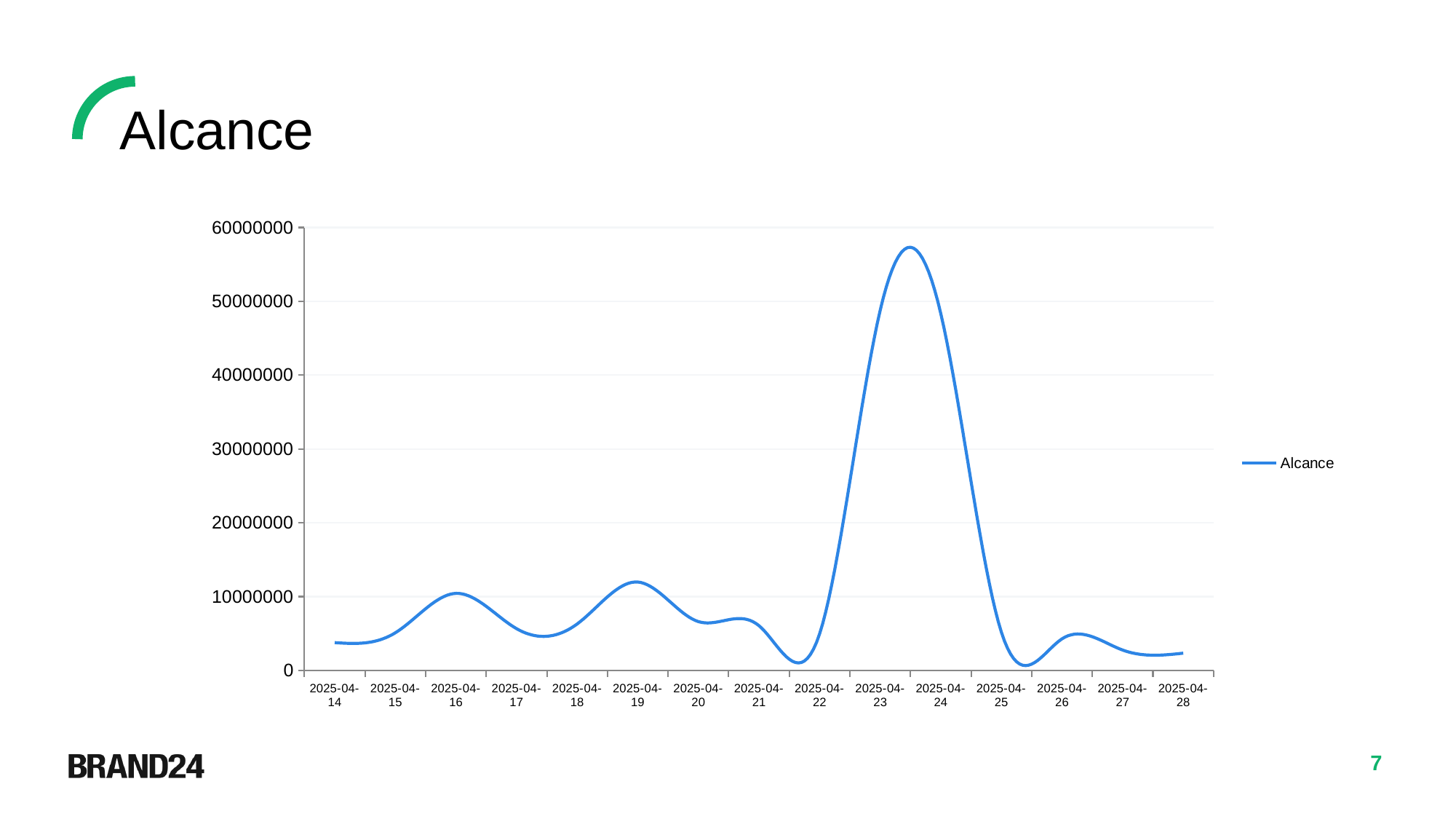
What kind of chart is shown on the slide? line chart Is the value for 2025-04-22 greater or less than 10000000? less Does the line rise or fall from 2025-04-24 to 2025-04-25? fall Is the value for 2025-04-23 greater or less than 30000000? greater How many series does the legend list? 1 What is the name of the series shown in the legend? Alcance Is the value for 2025-04-14 greater or less than 10000000? less What is the highest value shown on the y axis? 60000000 How many dates are plotted along the x axis? 15 Which has the larger value, 2025-04-23 or 2025-04-16? 2025-04-23 Which has the larger value, 2025-04-19 or 2025-04-14? 2025-04-19